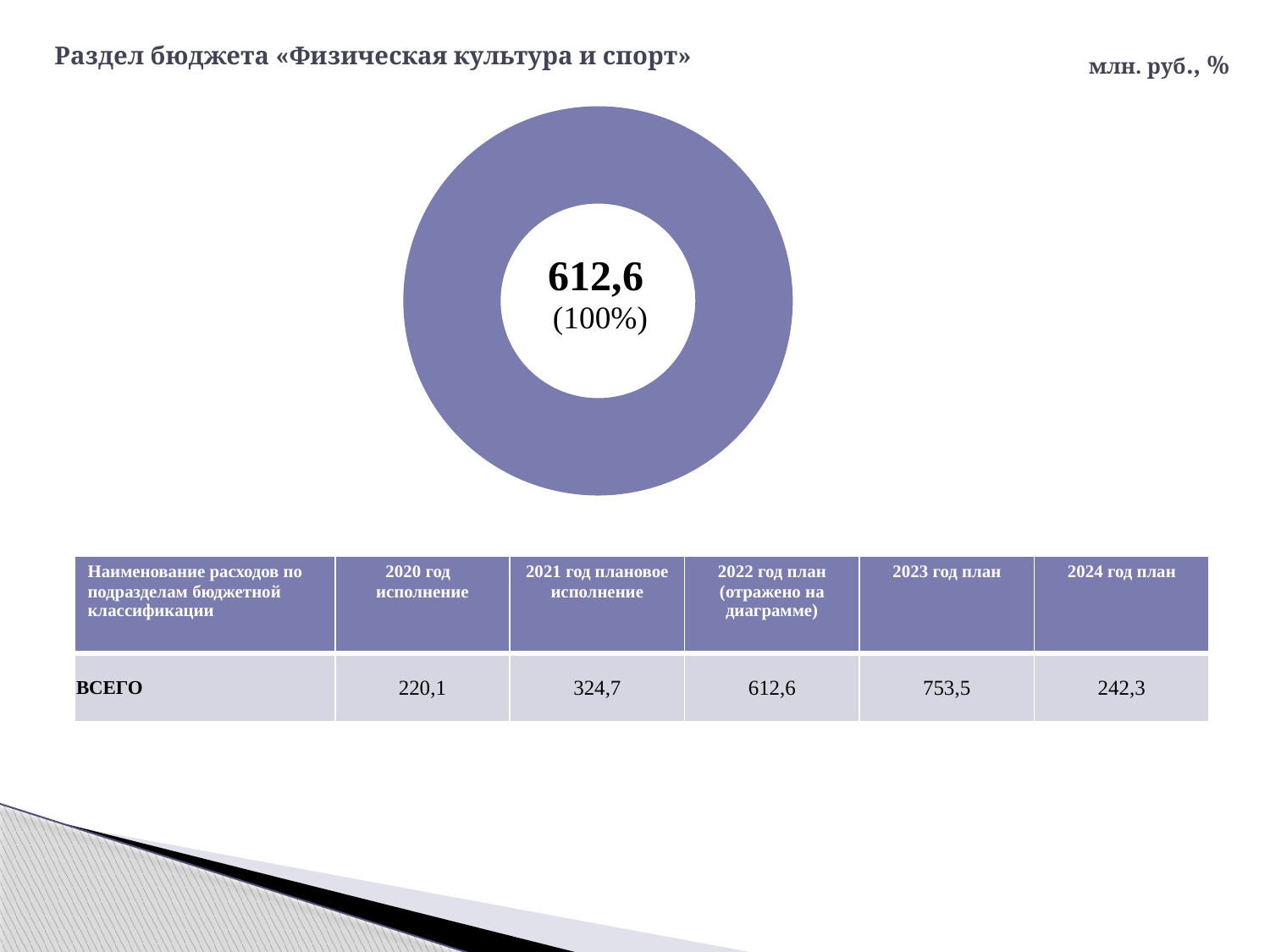
What units are indicated for the chart values in the top right of the slide? млн. руб., % What kind of chart is shown on the slide? Donut (pie) chart What share of the donut chart does the single slice represent? 100% Which year's value from the table is reflected in the donut chart? 2022 год план How many slices does the donut chart contain? 1 What is the value for 2022 год план shown in the donut chart? 612,6 What value is printed in the centre of the donut chart? 612,6